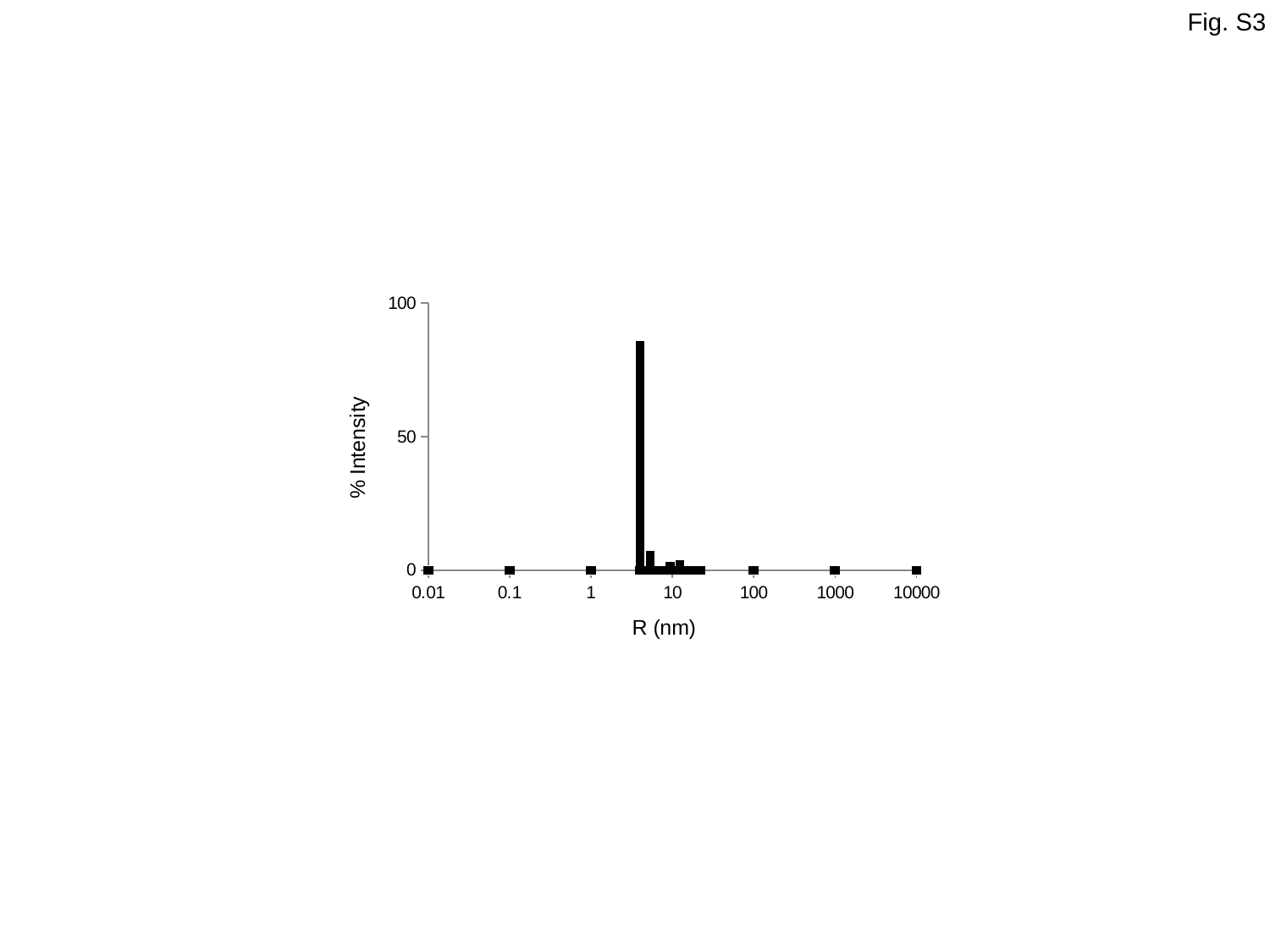
What is the largest labelled value on the x axis? 10000 What is the smallest labelled value on the x axis? 0.01 Is the value of the bar at R = 100 nm greater or less than 50? less What kind of chart is shown on the slide? bar chart What is the label of the x axis? R (nm) How many labelled tick values are shown on the x axis? 7 Is the value of the tallest bar greater or less than 50? greater Is the value of the bar at R = 1 nm greater or less than 50? less Between which two labelled x-axis ticks does the tallest bar lie? 1 and 10